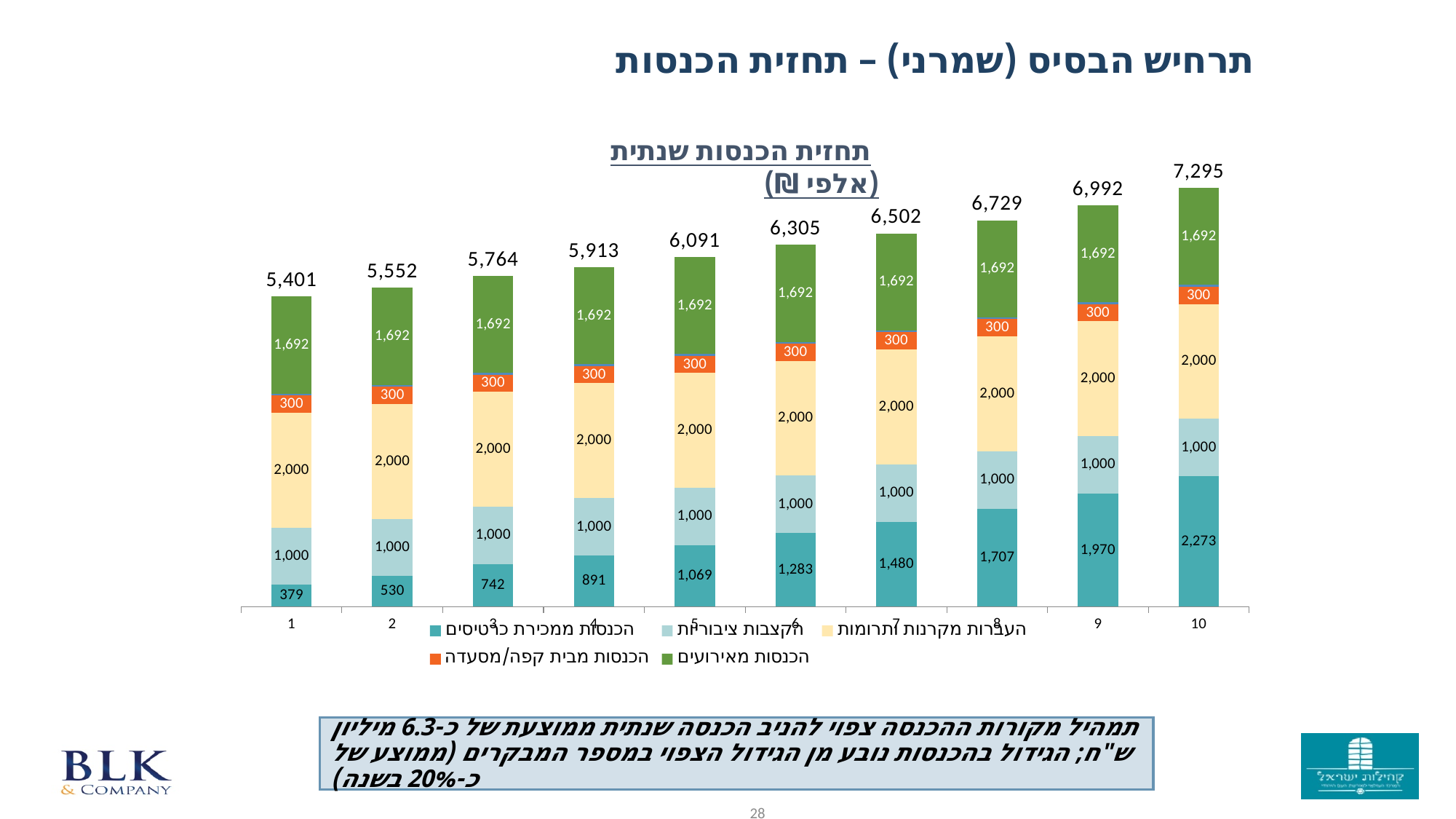
What is the value of הכנסות מאירועים (events revenue) in year 7? 1,692 Which year has the lowest total annual revenue? 1 What is the value of הכנסות ממכירת כרטיסים (ticket sales revenue) in year 1? 379 What is the total annual revenue shown above the bar for year 1? 5,401 Do the total annual revenues rise or fall from year 1 to year 10? rise What is the value of העברות מקרנות ותרומות (transfers from funds and donations) in year 3? 2,000 Which year has the highest total annual revenue? 10 How many series does the legend list? 5 What is the difference between the total revenue in year 10 and year 1? 1,894 What type of chart is shown on the slide? stacked bar chart What is the value of הכנסות ממכירת כרטיסים (ticket sales revenue) in year 5? 1,069 What is the total annual revenue shown above the bar for year 10? 7,295